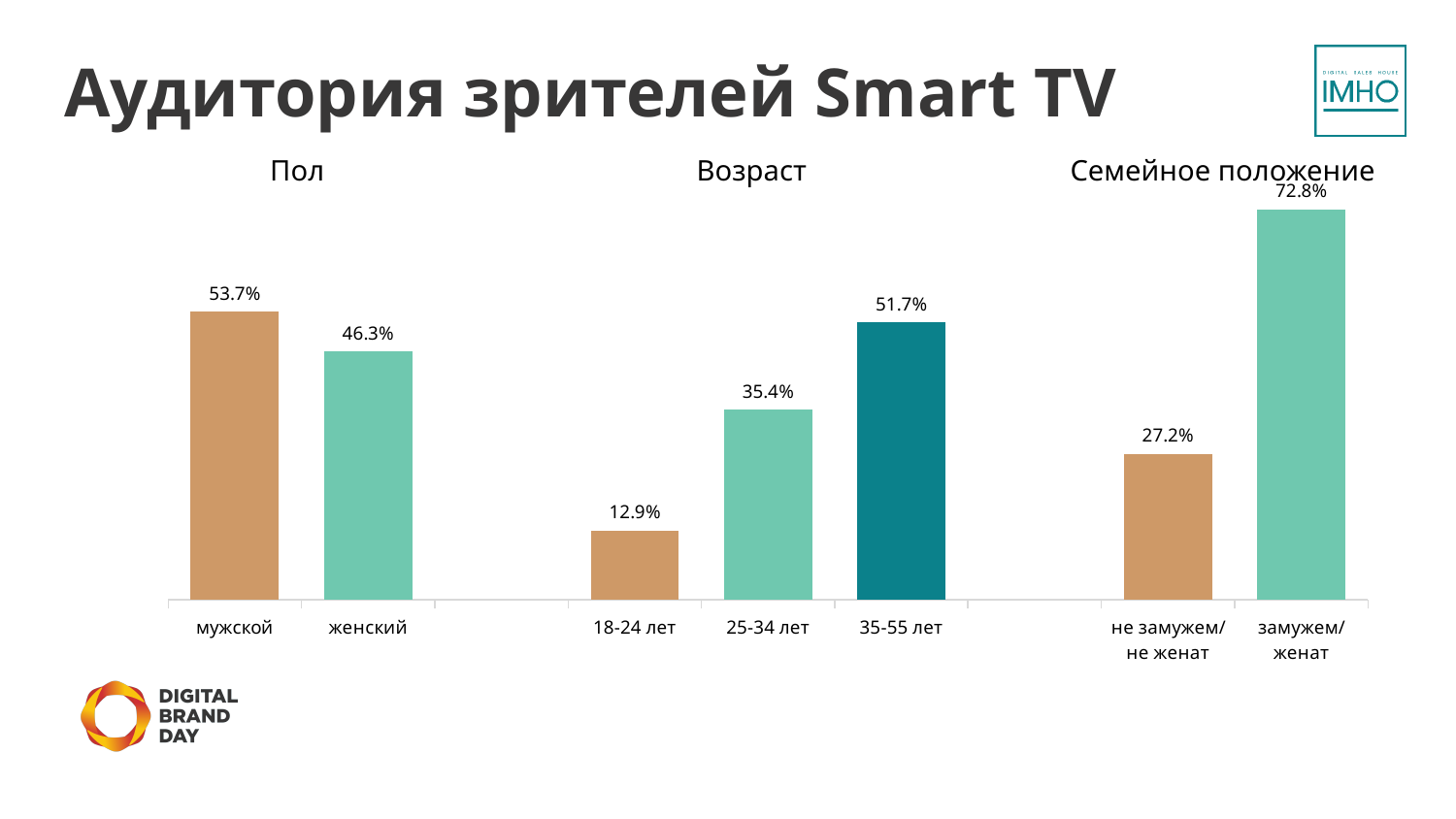
What is the difference between замужем/женат and не замужем/не женат in the Семейное положение section? 45.6% What is the value for 18-24 лет in the Возраст section? 12.9% Which age group in the Возраст section has the lowest value? 18-24 лет What type of chart is shown on the slide? Bar chart What is the difference between мужской and женский in the Пол section? 7.4% What is the value for женский in the Пол section? 46.3% Which is larger: 25-34 лет or 35-55 лет in the Возраст section? 35-55 лет What is the value for 35-55 лет in the Возраст section? 51.7% How many bars are plotted on the chart in total? 7 What is the value for мужской in the Пол section? 53.7% What is the value for замужем/женат in the Семейное положение section? 72.8% Which age group in the Возраст section has the highest value? 35-55 лет